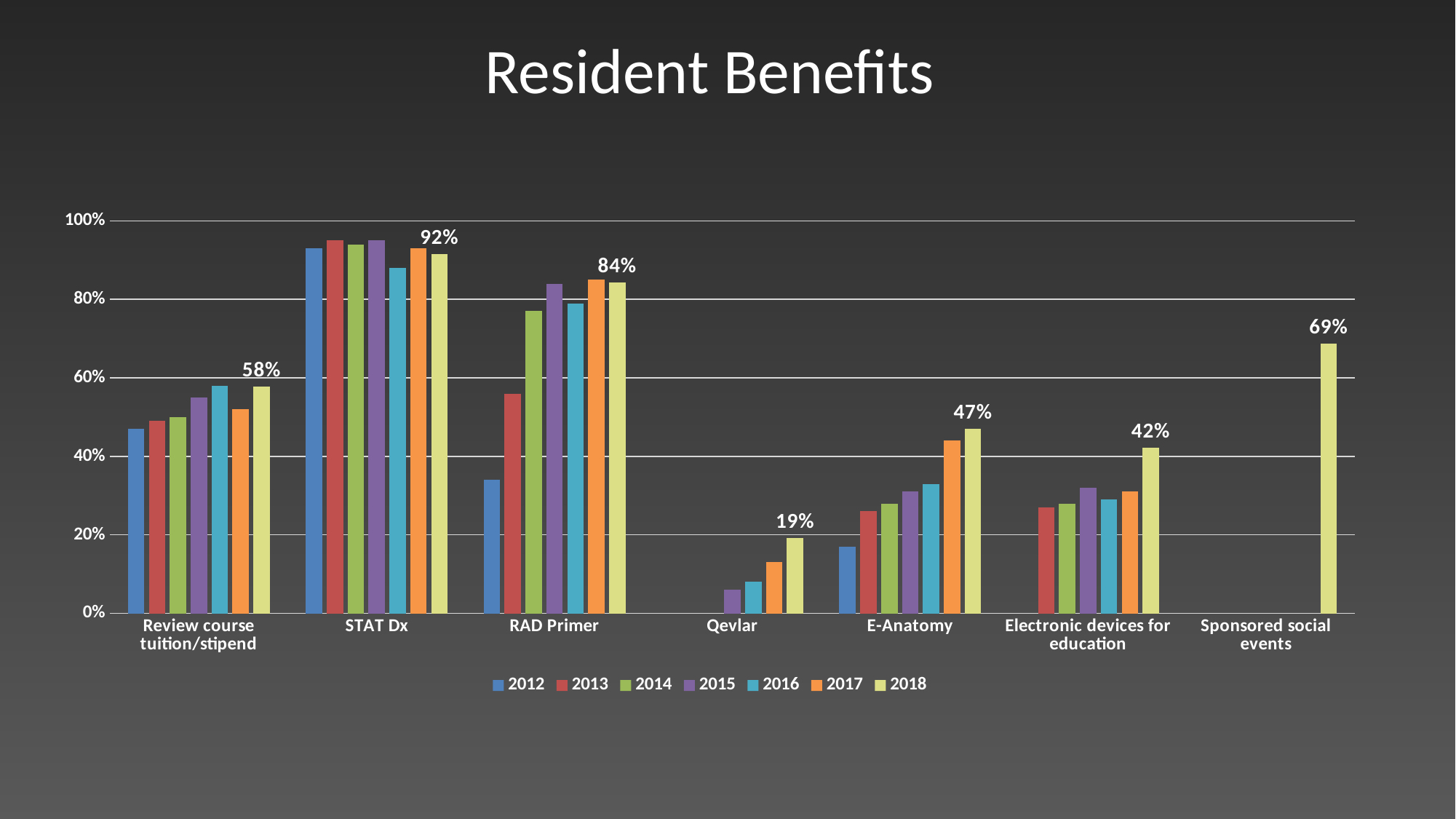
Which has the larger 2018 value, E-Anatomy or Electronic devices for education? E-Anatomy What is the difference between the 2018 values for STAT Dx and Review course tuition/stipend? 34 percentage points What is the 2018 value for STAT Dx? 92% Is the 2012 value for RAD Primer greater or less than 40%? less What is the 2018 value for Sponsored social events? 69% What kind of chart is shown on the slide? Bar chart How many categories are shown on the x axis? 7 What is the 2018 value for Qevlar? 19% What is the 2018 value for Review course tuition/stipend? 58% Which category has the highest 2018 value? STAT Dx Which category has the lowest 2018 value? Qevlar How many series does the legend list? 7